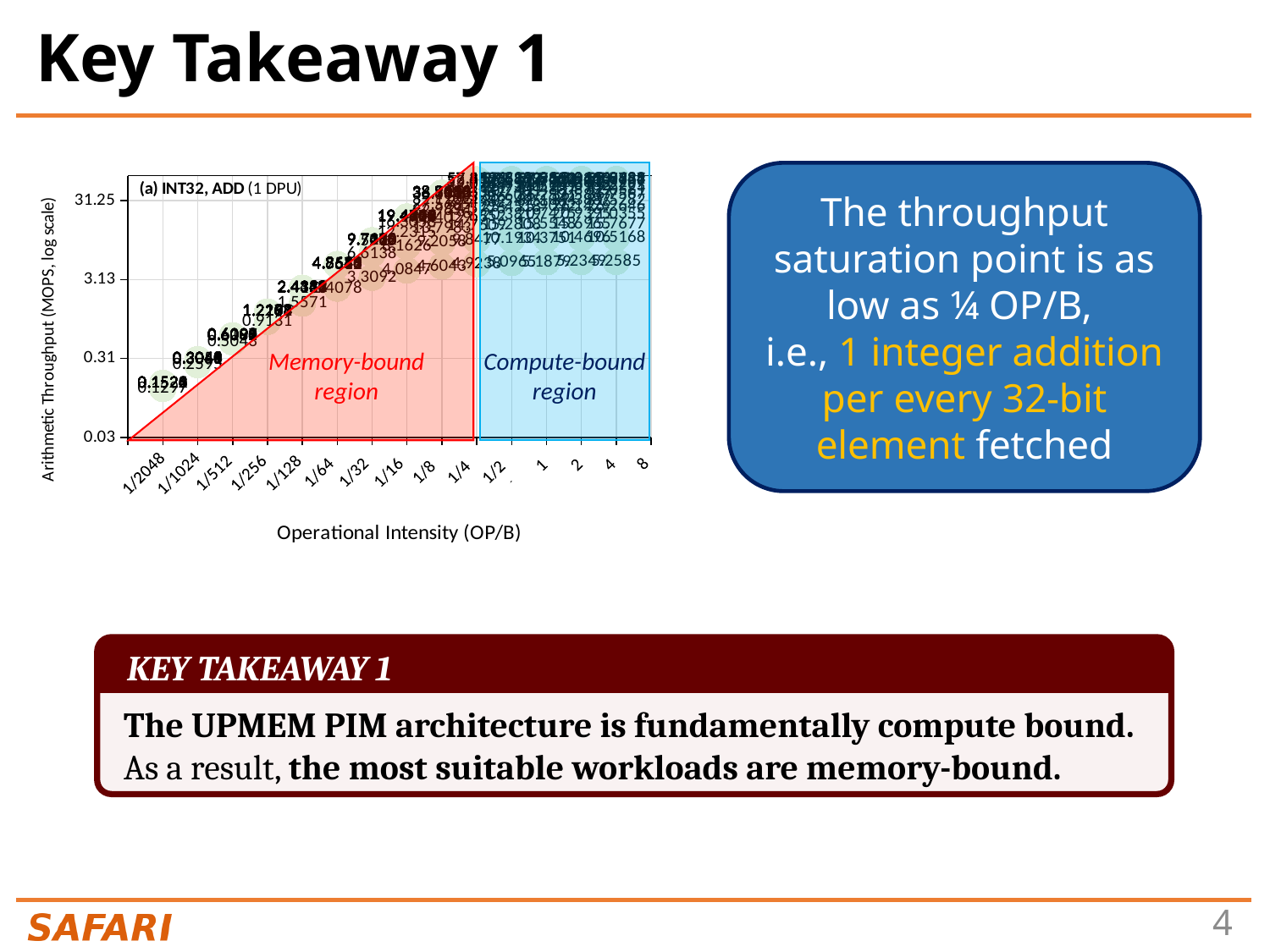
How many operational intensity values are marked on the x axis of the chart? 15 What is the label of the x axis of the chart? Operational Intensity (OP/B) How does arithmetic throughput change as operational intensity increases from 1/2048 to 1/4? It rises Which has the higher arithmetic throughput: operational intensity 1/2048 or 1/4? 1/4 What is the label of the y axis of the chart? Arithmetic Throughput (MOPS, log scale) What kind of chart is shown on the slide? scatter chart Is the arithmetic throughput at operational intensity 8 greater or less than 3.13? greater At which operational intensity is the arithmetic throughput lowest? 1/2048 Is the arithmetic throughput at operational intensity 1/128 greater or less than 0.31? greater Is the arithmetic throughput at operational intensity 1/512 greater or less than 3.13? less